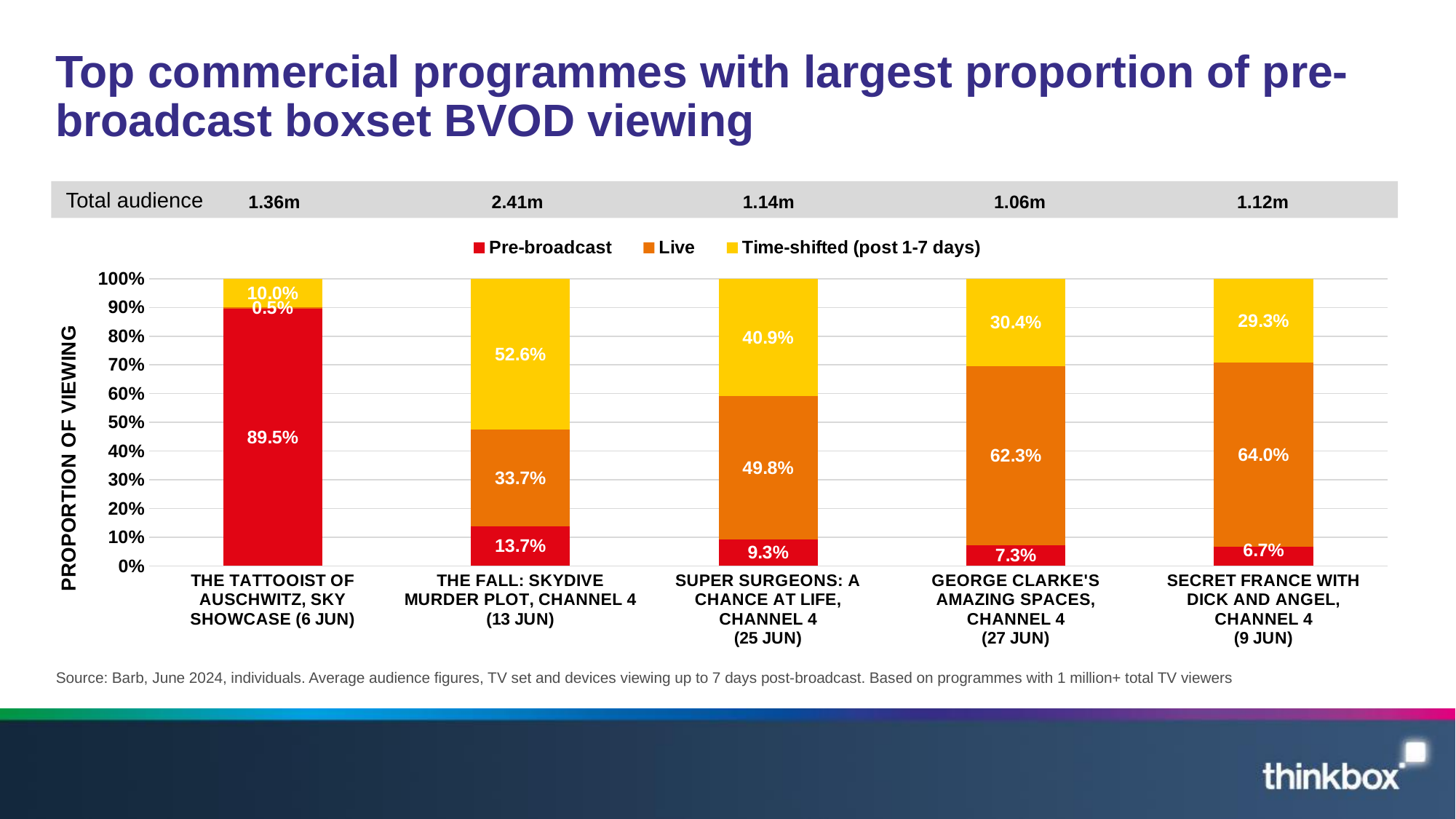
What is the Live share for George Clarke's Amazing Spaces, Channel 4 (27 Jun)? 62.3% What is the Time-shifted (post 1-7 days) share for The Fall: Skydive Murder Plot, Channel 4 (13 Jun)? 52.6% Which programme has the lowest Pre-broadcast share? Secret France with Dick and Angel, Channel 4 (9 Jun) Which programme has the highest Pre-broadcast share? The Tattooist of Auschwitz, Sky Showcase (6 Jun) What kind of chart is shown on the slide? Stacked bar chart What is the difference between the Live share for Secret France with Dick and Angel and the Live share for Super Surgeons: A Chance at Life? 14.2% How many programmes are shown on the chart? 5 Which is larger: the Time-shifted share for Super Surgeons: A Chance at Life or the Time-shifted share for George Clarke's Amazing Spaces? Super Surgeons: A Chance at Life What is the total audience shown for The Fall: Skydive Murder Plot, Channel 4 (13 Jun)? 2.41m Is the Live share for The Fall: Skydive Murder Plot greater or less than 40%? less What is the Pre-broadcast share for The Tattooist of Auschwitz, Sky Showcase (6 Jun)? 89.5% How many series does the legend list? 3